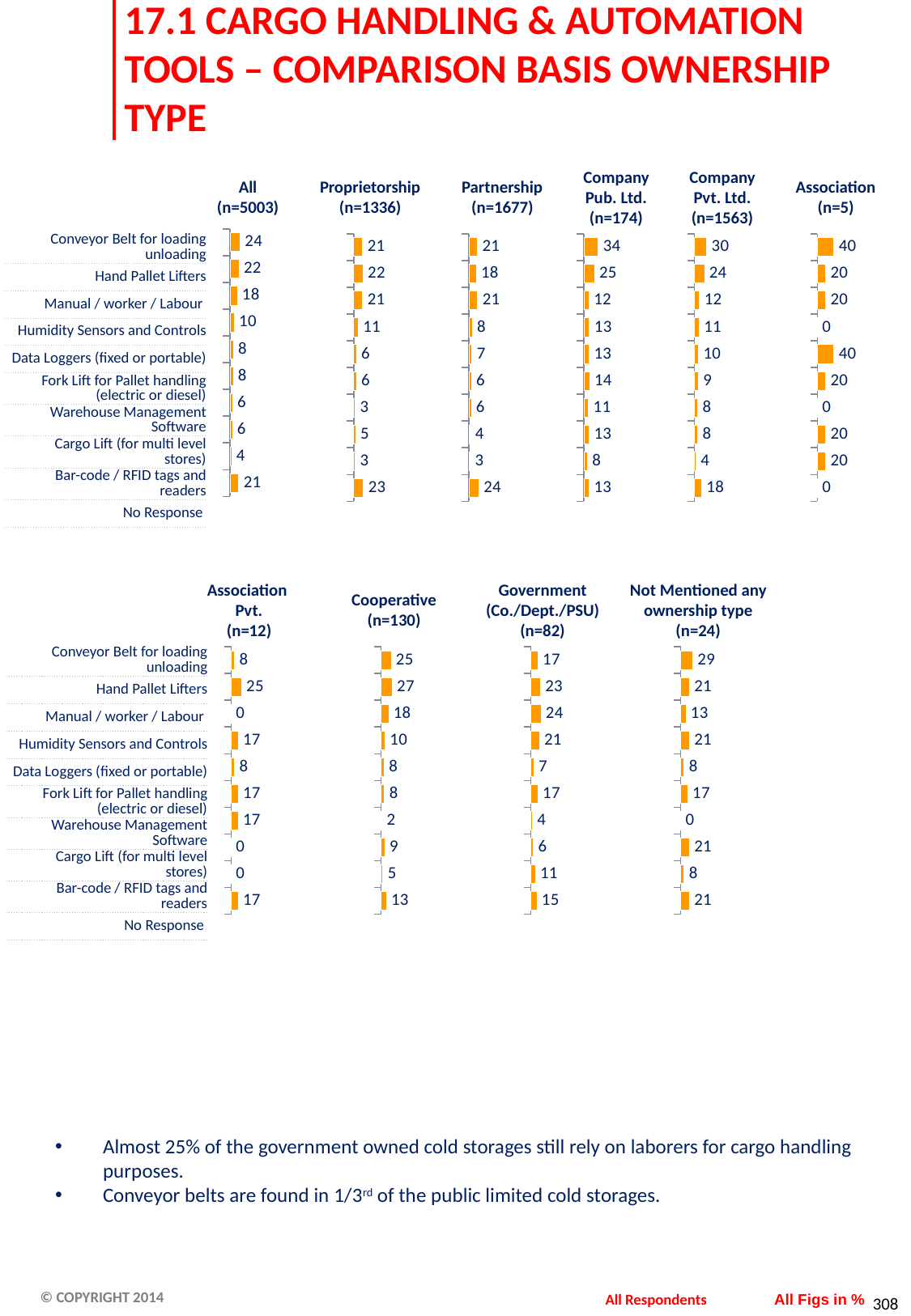
In the 'Government (Co./Dept./PSU) (n=82)' chart, what is the value for Manual / worker / Labour? 24 In the 'Partnership (n=1677)' chart, what is the difference between Conveyor Belt for loading unloading and Hand Pallet Lifters? 3 In the 'Association (n=5)' chart, what is the value for Humidity Sensors and Controls? 0 In the 'All (n=5003)' chart, what is the value for Conveyor Belt for loading unloading? 24 In the 'Cooperative (n=130)' chart, what is the value for Hand Pallet Lifters? 27 What kind of chart is used for each ownership type on this slide? Bar chart In the 'Company Pub. Ltd. (n=174)' chart, what is the value for Conveyor Belt for loading unloading? 34 In the 'Not Mentioned any ownership type (n=24)' chart, what is the value for Conveyor Belt for loading unloading? 29 In the 'Association Pvt. (n=12)' chart, what is the value for Hand Pallet Lifters? 25 In the 'Company Pvt. Ltd. (n=1563)' chart, which category has the highest value? Conveyor Belt for loading unloading In the 'Company Pub. Ltd. (n=174)' chart, which is larger: Conveyor Belt for loading unloading or Hand Pallet Lifters? Conveyor Belt for loading unloading